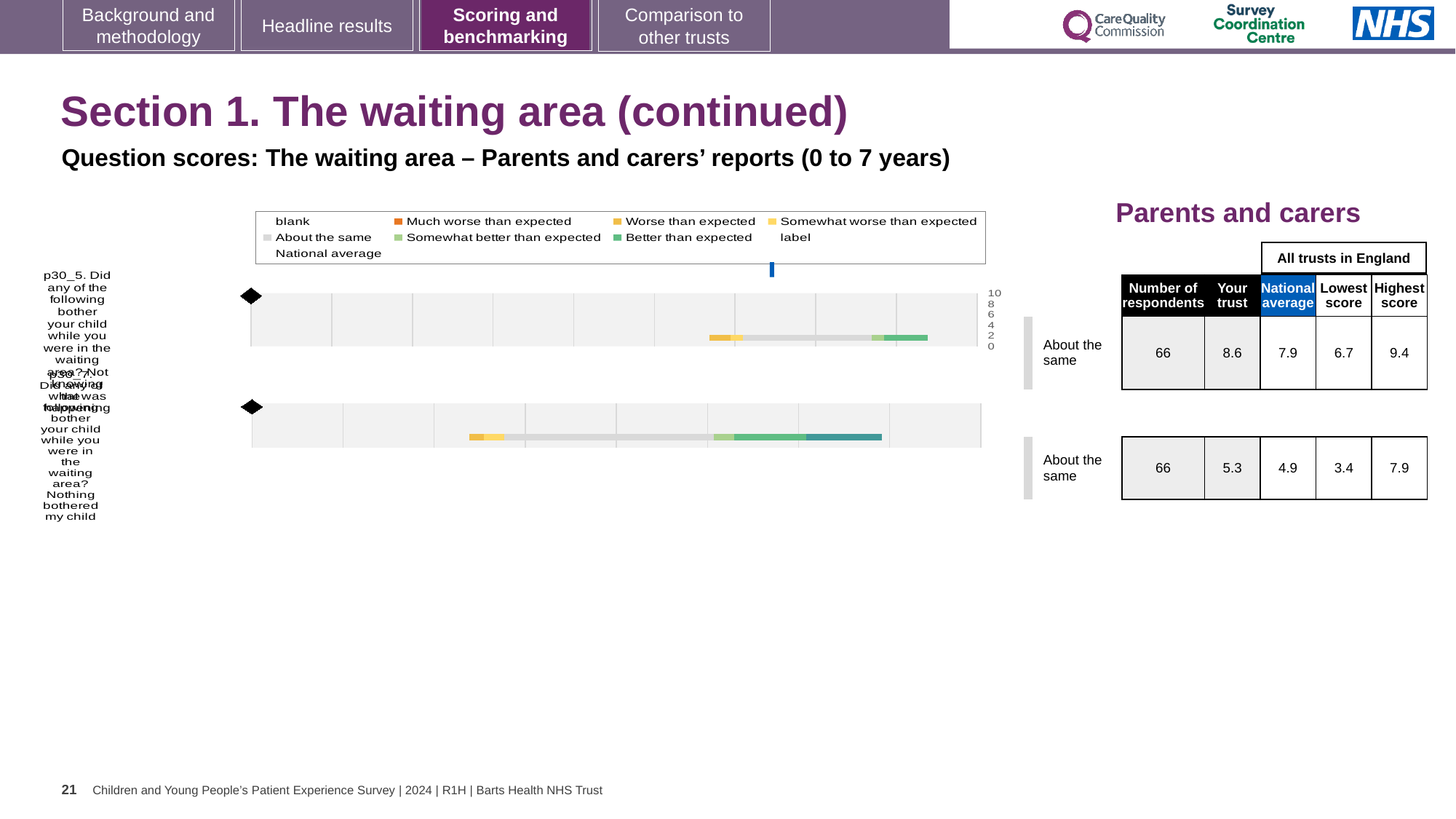
For question p30_7, what is the difference between the 'Your trust' score and the national average? 0.4 For question p30_5, what is the difference between the highest score and the lowest score across all trusts in England? 2.7 How many questions (bars) are plotted in the chart? 2 According to the table beside the chart, what is the 'Your trust' score for question p30_5? 8.6 What kind of chart is shown on the slide? bar chart What benchmark category label is shown next to both bars in the chart? About the same Which question has the higher 'Your trust' score, p30_5 or p30_7? p30_5 According to the table beside the chart, what is the national average for question p30_7? 4.9 What is the lowest score across all trusts in England for question p30_7? 3.4 For question p30_5, which is larger: the 'Your trust' score or the national average? Your trust How many respondents are listed for question p30_7? 66 What colour does the legend use for 'Much worse than expected'? orange